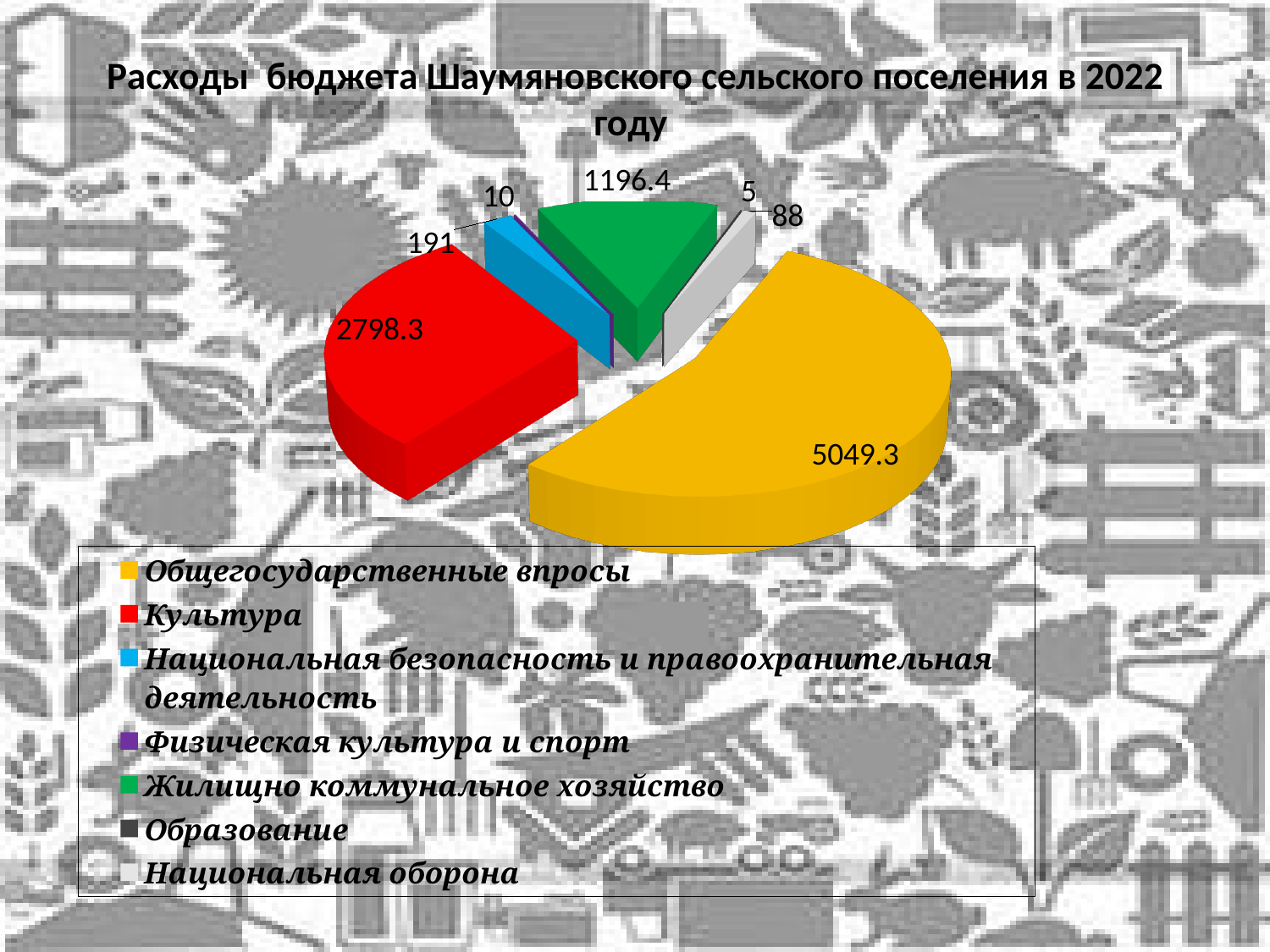
What is the value for Культура? 2798.3 What is the value for Национальная оборона? 88 Which category has the largest slice of the pie? Общегосударственные впросы How many categories does the legend list? 7 What is the title of the chart? Расходы бюджета Шаумяновского сельского поселения в 2022 году Which is larger: the value for Национальная безопасность и правоохранительная деятельность or the value for Национальная оборона? Национальная безопасность и правоохранительная деятельность What is the difference between the values for Общегосударственные впросы and Культура? 2251 What is the value for Жилищно коммунальное хозяйство? 1196.4 Which category has the smallest value? Образование What colour is the slice for Культура? Red What is the value for Общегосударственные впросы? 5049.3 What type of chart is shown on the slide? Pie chart